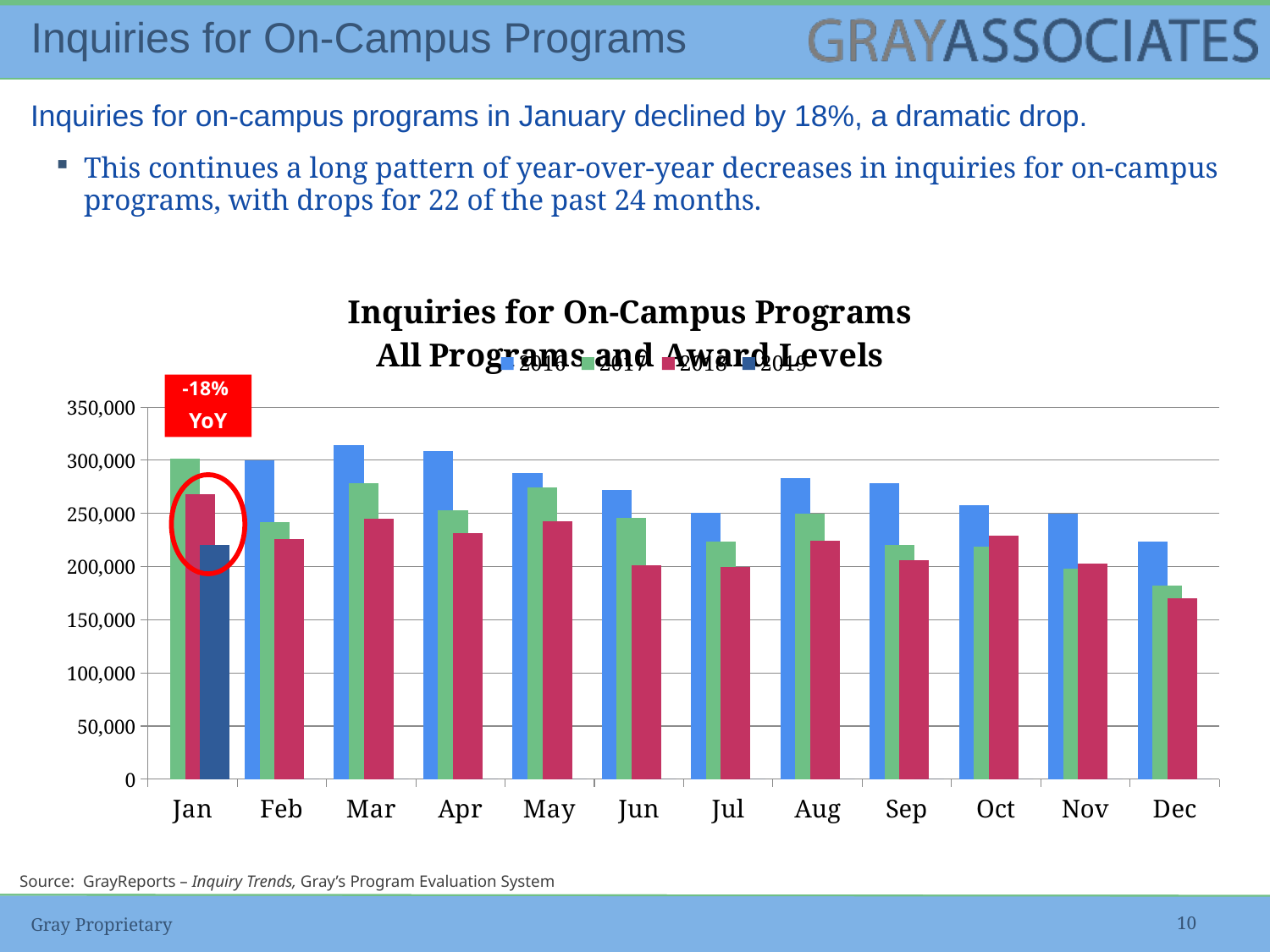
What year-over-year change is called out in the red box above the January bars? -18% YoY What kind of chart is shown on the slide? bar chart Is the value for 2018 in Jan greater or less than 250,000? greater Is the value for 2019 in Jan greater or less than 250,000? less Which month has the highest value for the 2017 series? Jan How many series does the chart legend list? 4 Which month has the lowest value for the 2018 series? Dec Is the value for 2016 in Mar greater or less than 300,000? greater Which month is the only one with a 2019 bar in the chart? Jan In Jan, which is larger: the 2018 bar or the 2019 bar? 2018 How many months are shown on the x axis of the chart? 12